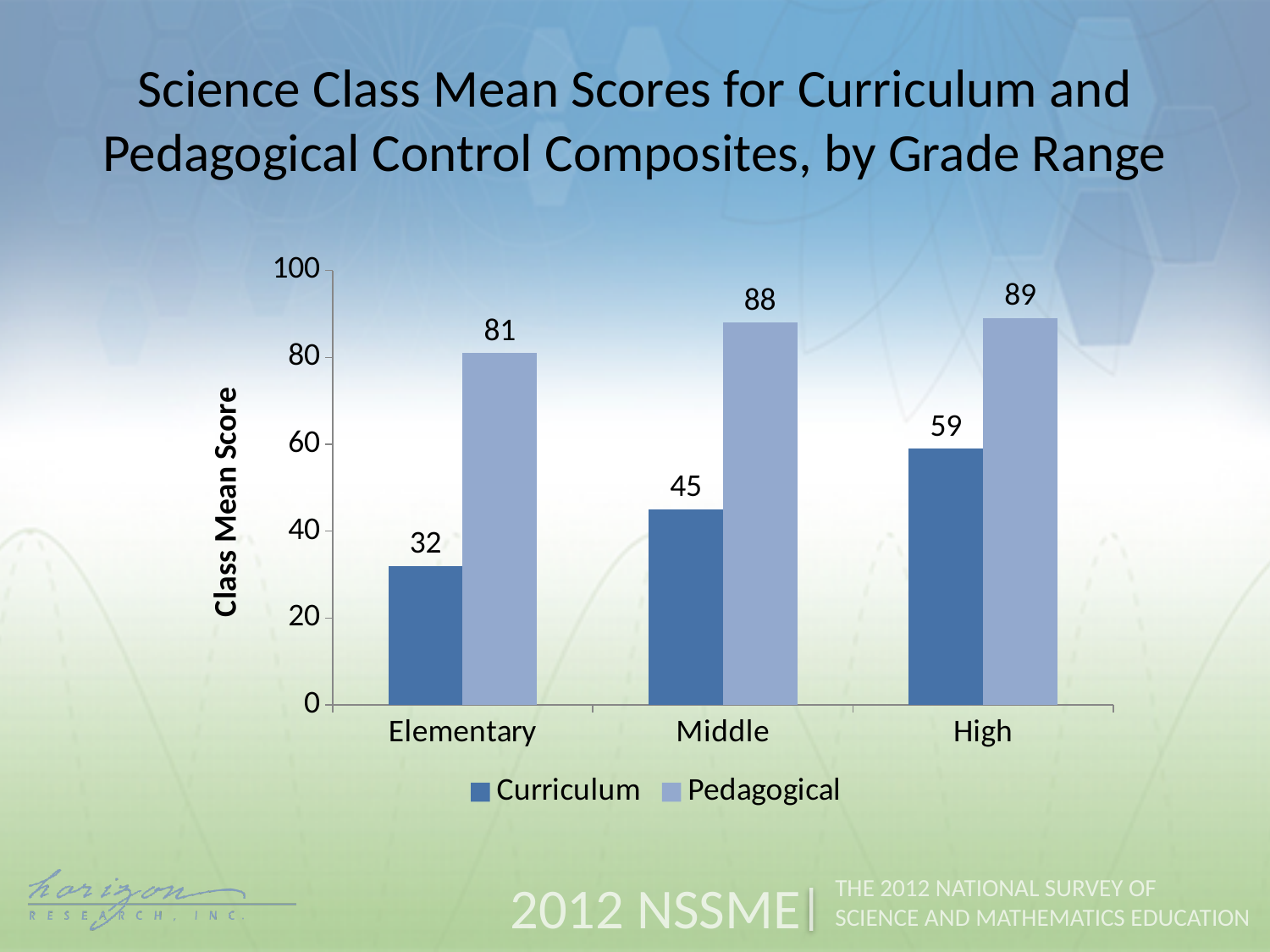
How many series does the legend list? 2 Which grade range has the highest Curriculum score? High What is the difference between the Pedagogical and Curriculum scores for Elementary? 49 What is the Curriculum class mean score for Elementary? 32 Do the Curriculum scores rise or fall from Elementary to High? Rise What is the Curriculum class mean score for High? 59 What is the Pedagogical class mean score for Middle? 88 How many grade ranges are shown on the x axis? 3 Which grade range has the lowest Pedagogical score? Elementary What kind of chart is shown on the slide? Bar chart What is the difference between the Curriculum scores for High and Middle? 14 Which is larger, the Curriculum score for Middle or the Curriculum score for Elementary? Middle